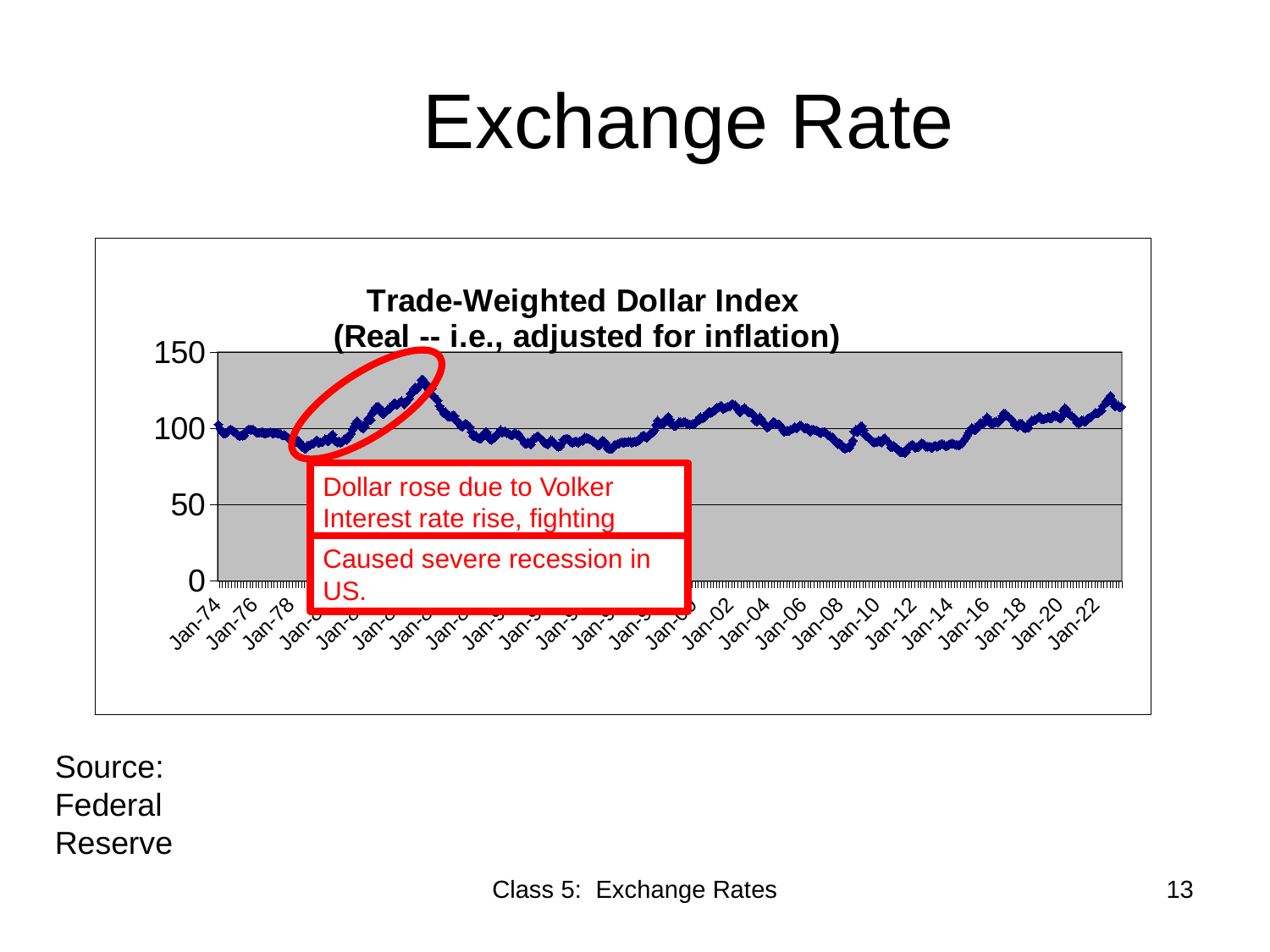
Is the value of the Trade-Weighted Dollar Index around Jan-96 greater or less than 50? greater Is the value of the Trade-Weighted Dollar Index around Jan-85 greater or less than 100? greater What is the highest value shown on the y axis of the chart? 150 Does the Trade-Weighted Dollar Index rise or fall between Jan-80 and Jan-85? rise What is the title of the chart? Trade-Weighted Dollar Index (Real -- i.e., adjusted for inflation) What kind of chart is shown on the slide? line chart Does the Trade-Weighted Dollar Index rise or fall between Jan-85 and Jan-88? fall Is the value of the Trade-Weighted Dollar Index around Jan-22 greater or less than 100? greater What is the first date label on the x axis of the chart? Jan-74 Which is larger, the Trade-Weighted Dollar Index around Jan-85 or around Jan-95? Jan-85 Around which year does the Trade-Weighted Dollar Index reach its highest point? around 1985